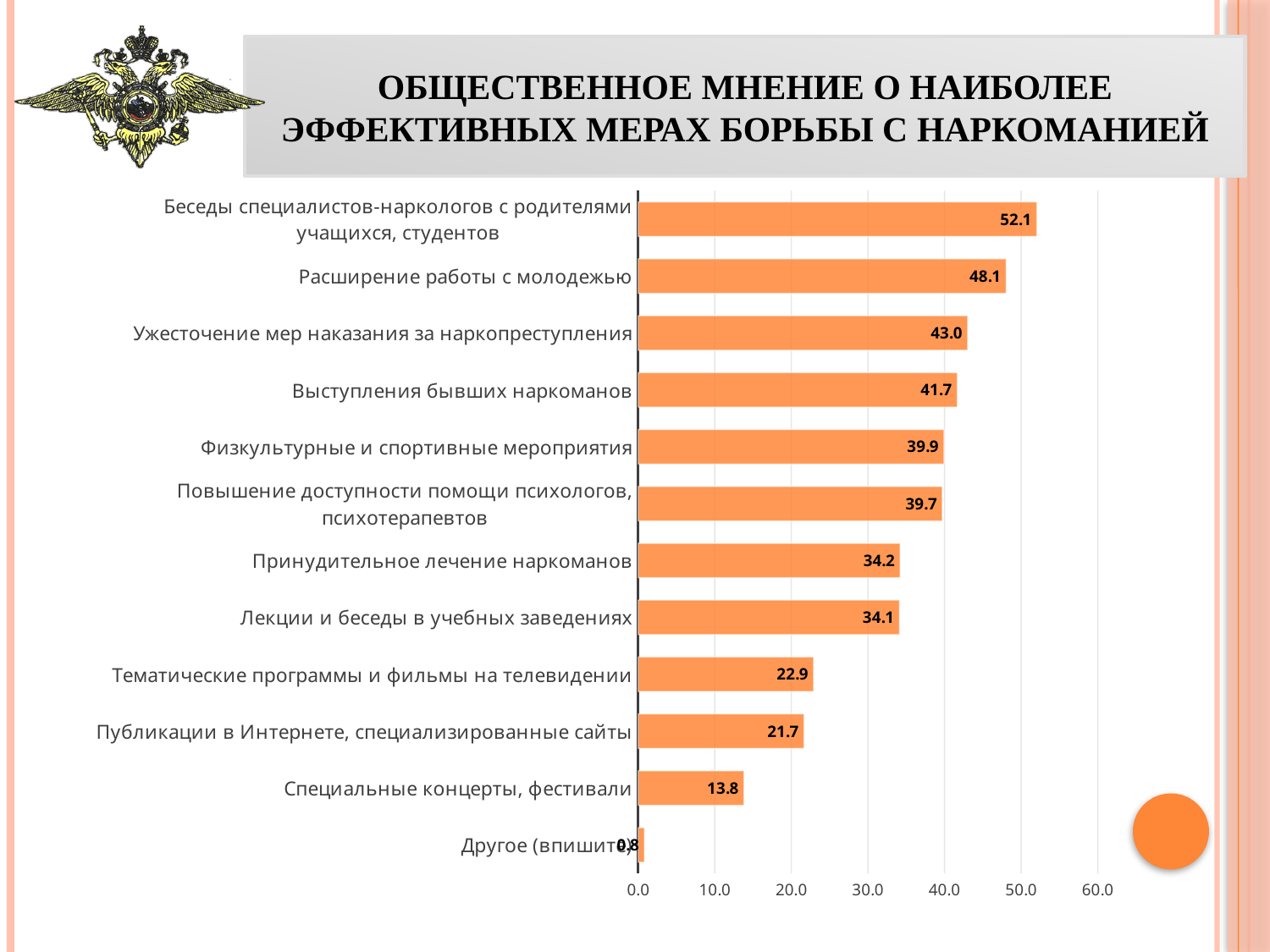
How many categories (measures) are plotted in the chart? 12 What type of chart is shown on the slide? bar chart Is the value for "Лекции и беседы в учебных заведениях" greater or less than 30.0? greater What is the title of the slide containing the chart? ОБЩЕСТВЕННОЕ МНЕНИЕ О НАИБОЛЕЕ ЭФФЕКТИВНЫХ МЕРАХ БОРЬБЫ С НАРКОМАНИЕЙ What is the difference between the highest value (52.1) and the value for "Расширение работы с молодежью" (48.1)? 4.0 Which category has the lowest value? Другое (впишите) What is the value for "Выступления бывших наркоманов"? 41.7 What is the value for "Расширение работы с молодежью"? 48.1 What is the value for "Специальные концерты, фестивали"? 13.8 What is the difference between the values for "Ужесточение мер наказания за наркопреступления" and "Принудительное лечение наркоманов"? 8.8 Which is larger: the value for "Тематические программы и фильмы на телевидении" or for "Публикации в Интернете, специализированные сайты"? Тематические программы и фильмы на телевидении Which category has the highest value? Беседы специалистов-наркологов с родителями учащихся, студентов